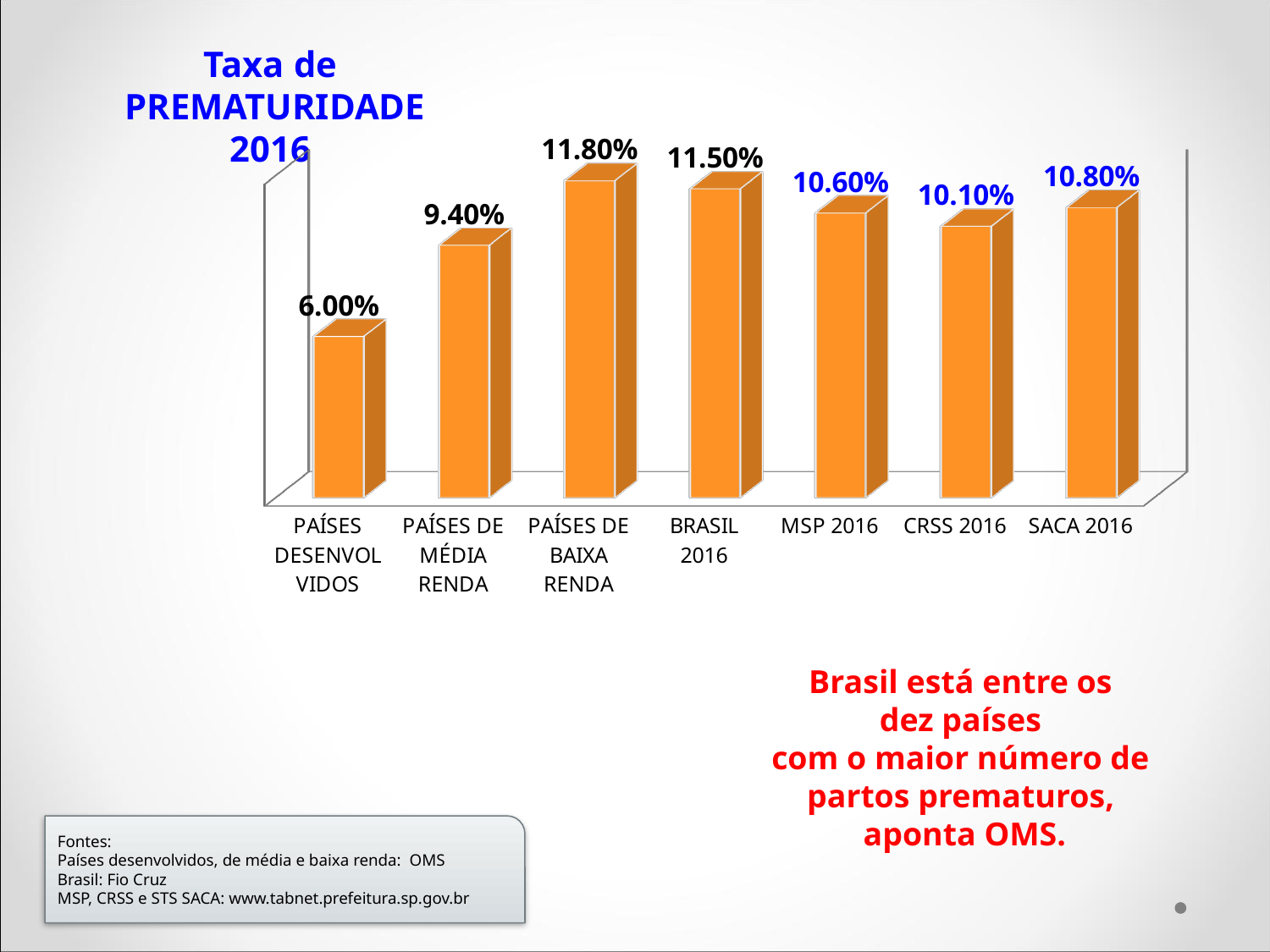
Which category has the lowest value? PAÍSES DESENVOLVIDOS What is the value for SACA 2016? 10.80% What is the value for CRSS 2016? 10.10% What is the difference between the values for PAÍSES DE BAIXA RENDA and PAÍSES DE MÉDIA RENDA? 2.40% What is the title of the chart? Taxa de PREMATURIDADE 2016 How many categories are shown in the chart? 7 What is the value for PAÍSES DESENVOLVIDOS? 6.00% What is the difference between the values for BRASIL 2016 and MSP 2016? 0.90% What is the value for BRASIL 2016? 11.50% Which category has the highest value? PAÍSES DE BAIXA RENDA What kind of chart is shown on the slide? Bar chart Which is larger, the value for MSP 2016 or the value for SACA 2016? SACA 2016